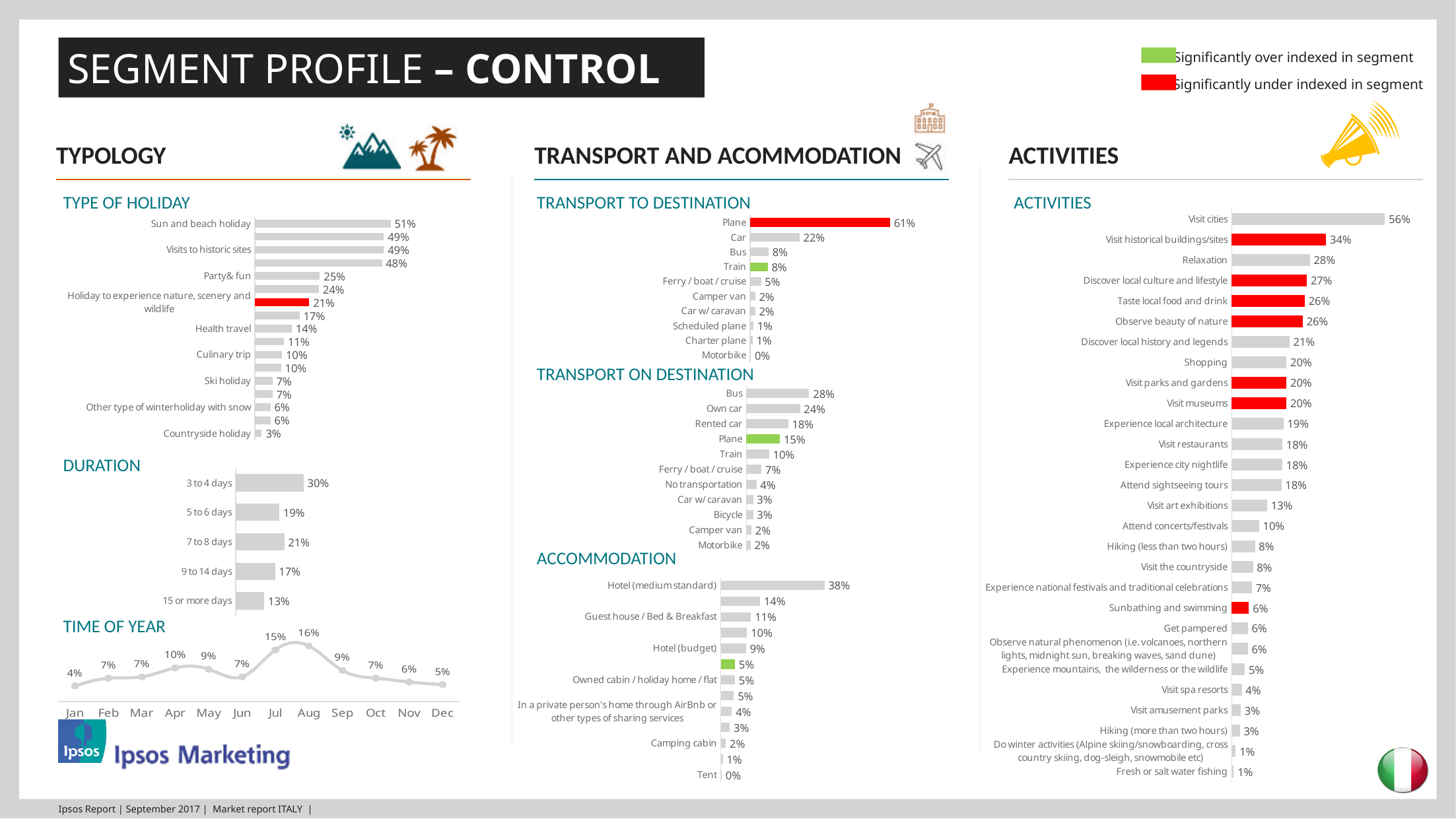
In the Activities chart, what is the difference between Visit cities and Visit historical buildings/sites? 22% In the Time of Year chart, what is the value for Jan? 4% In the Duration chart, how many categories are shown? 5 In the Transport to Destination chart, which category has the highest value? Plane In the Accommodation chart, what is the value for Hotel (medium standard)? 38% In the Time of Year chart, which month has the highest value? Aug In the Activities chart, what is the value for Visit cities? 56% In the Duration chart, which category has the lowest value? 15 or more days In the Duration chart, what is the value for 3 to 4 days? 30% In the Transport to Destination chart, what is the value for Plane? 61% In the Transport on Destination chart, which is larger, Bus or Own car? Bus What kind of chart is the Time of Year chart? Line chart